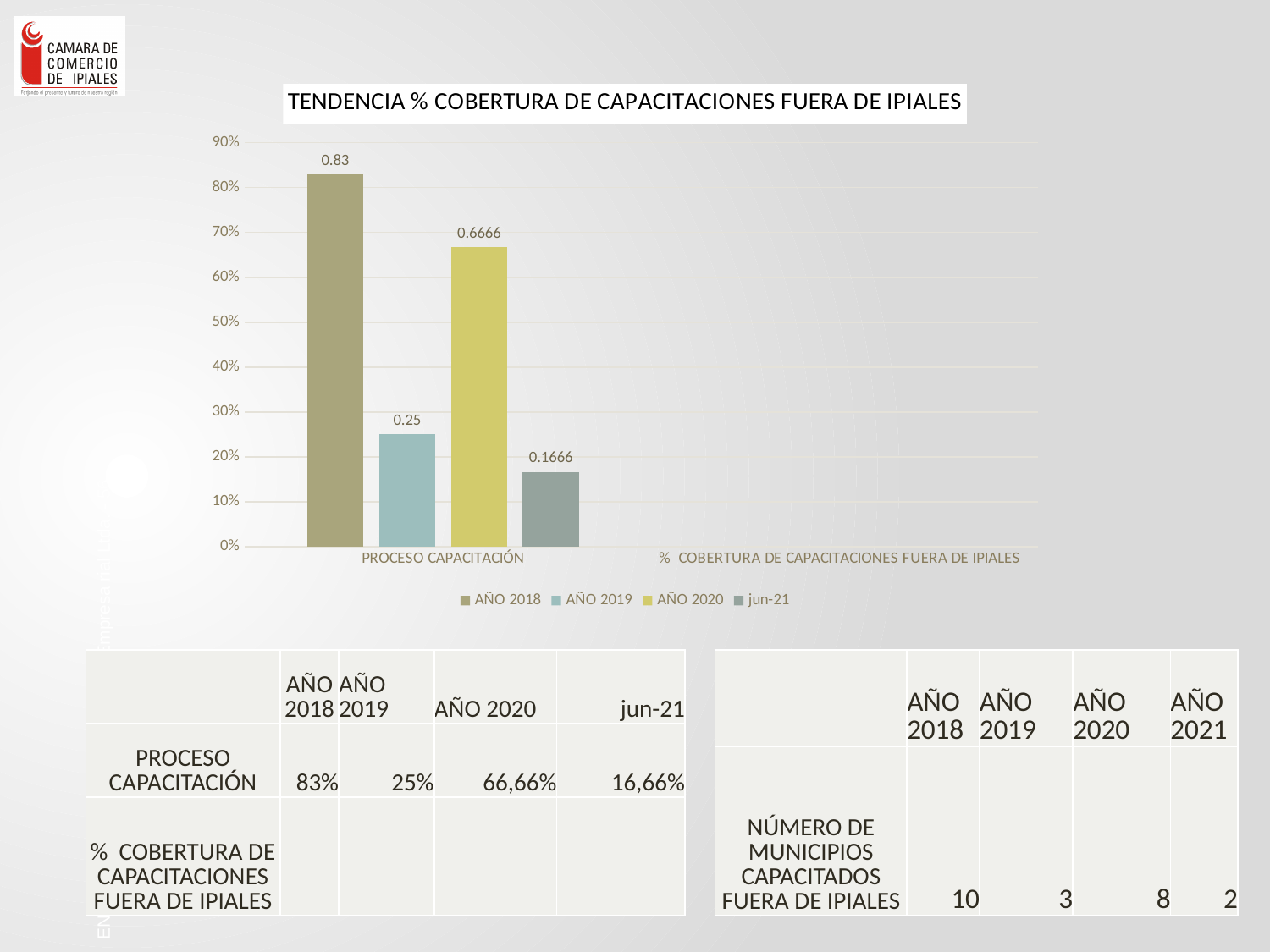
What is the value of the AÑO 2019 bar for PROCESO CAPACITACIÓN? 0.25 Which is larger for PROCESO CAPACITACIÓN, the AÑO 2020 value or the AÑO 2019 value? AÑO 2020 Which series has the lowest bar for PROCESO CAPACITACIÓN? jun-21 What is the difference between the AÑO 2018 and AÑO 2019 values for PROCESO CAPACITACIÓN? 0.58 What is the value of the jun-21 bar for PROCESO CAPACITACIÓN? 0.1666 What is the title of the chart? TENDENCIA % COBERTURA DE CAPACITACIONES FUERA DE IPIALES What kind of chart is shown on the slide? bar chart What is the value of the AÑO 2020 bar for PROCESO CAPACITACIÓN? 0.6666 Which series has the highest bar for PROCESO CAPACITACIÓN? AÑO 2018 How many series does the legend list? 4 What is the value of the AÑO 2018 bar for PROCESO CAPACITACIÓN? 0.83 Is the AÑO 2020 value for PROCESO CAPACITACIÓN greater or less than 60%? greater